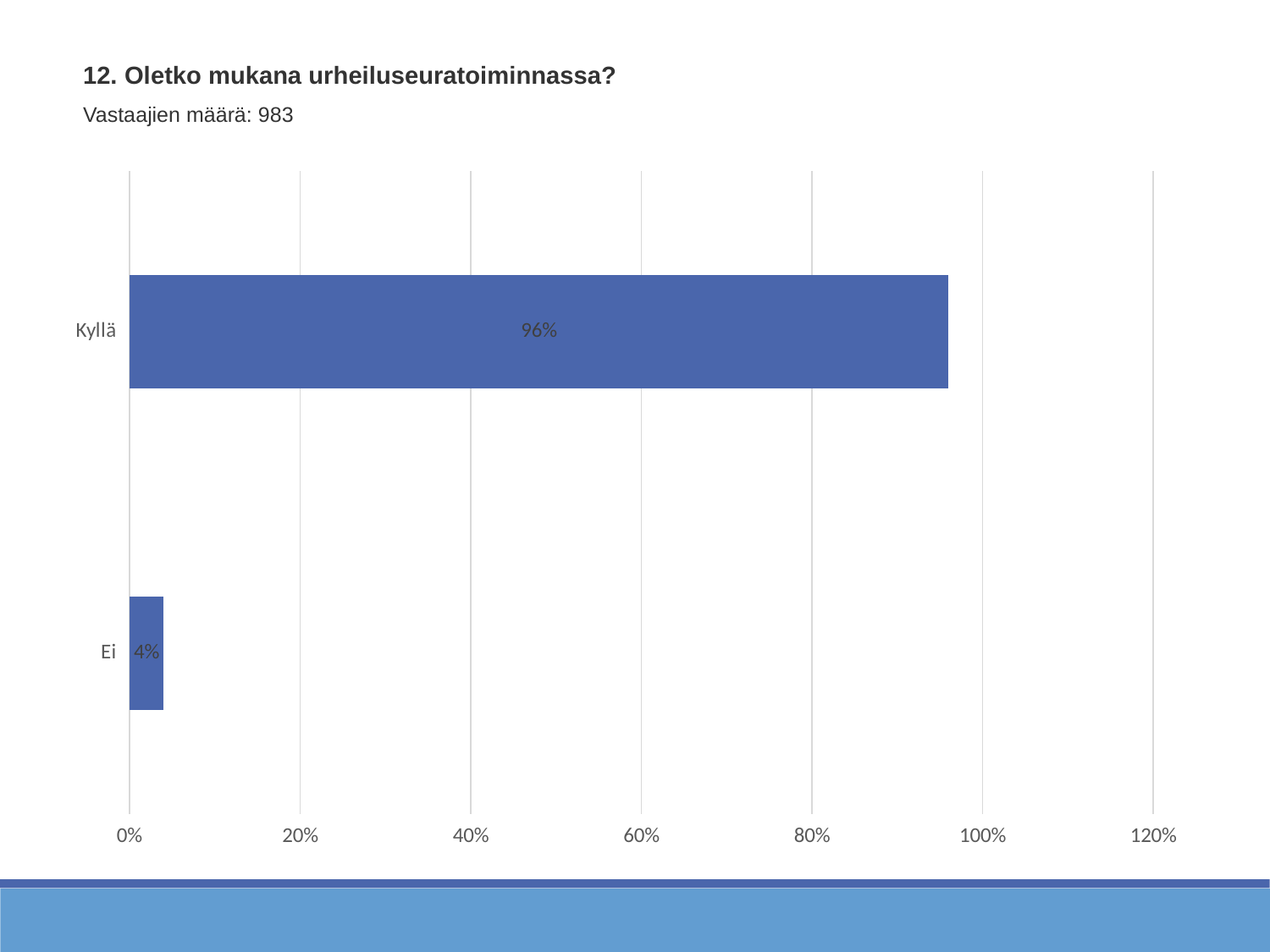
What is the title of the question shown above the chart? 12. Oletko mukana urheiluseuratoiminnassa? Is the value for Kyllä greater or less than 80%? greater How many categories are shown in the chart? 2 What is the value for Kyllä? 96% What is the difference between the values for Kyllä and Ei? 92% What is the value for Ei? 4% Is the value for Ei greater or less than 20%? less How many respondents (Vastaajien määrä) are stated on the slide? 983 Which category has the highest value? Kyllä Which is larger, the value for Kyllä or the value for Ei? Kyllä What kind of chart is shown on the slide? bar chart Which category has the lowest value? Ei